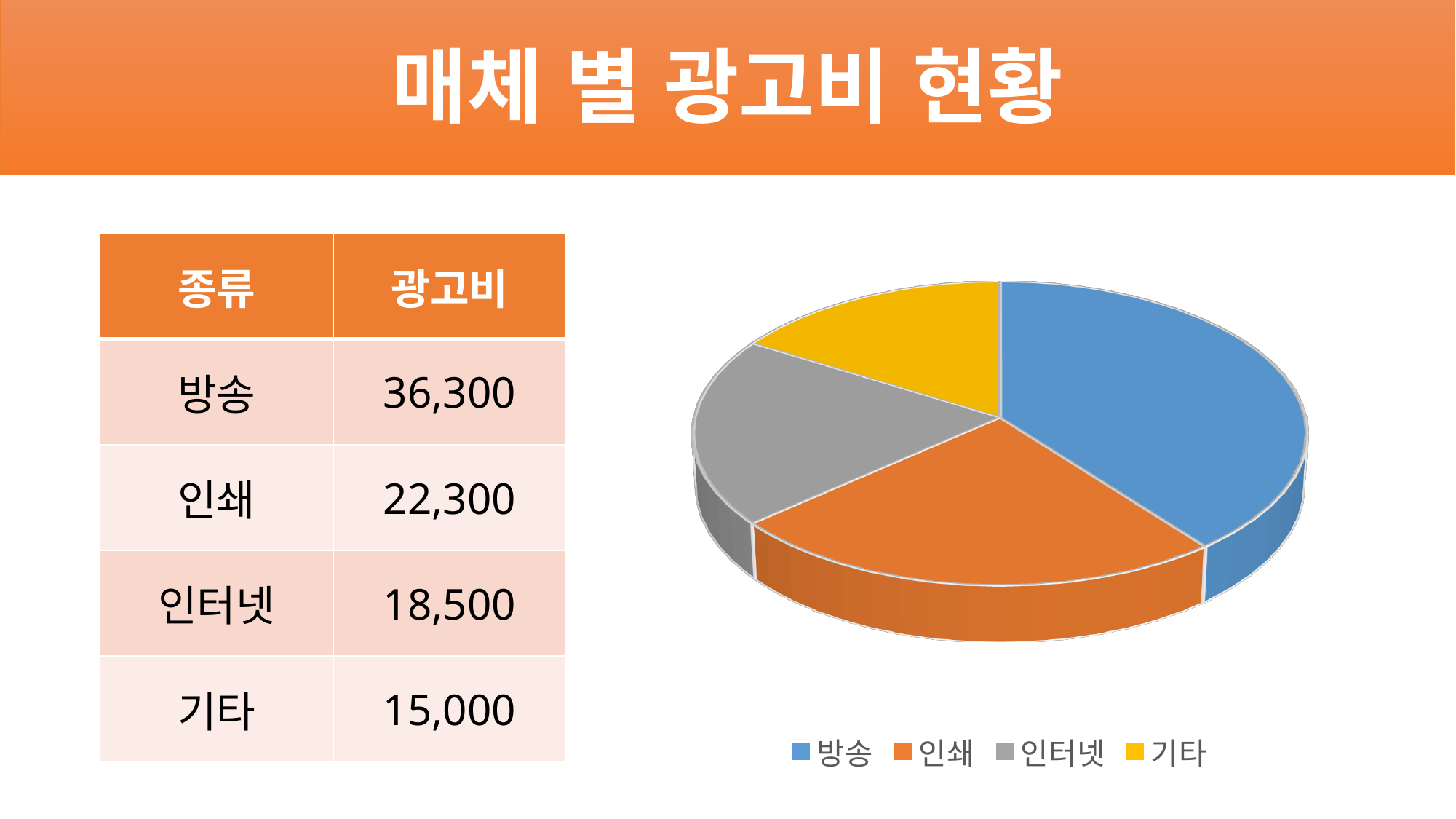
What is the 광고비 value for 인쇄? 22,300 Which category has the lowest 광고비? 기타 What colour is the 방송 slice in the pie chart? Blue Which has a larger 광고비, 인쇄 or 인터넷? 인쇄 What is the difference in 광고비 between 방송 and 인쇄? 14,000 How many categories does the pie chart have? 4 What is the 광고비 value for 인터넷? 18,500 What kind of chart is shown on the slide? Pie chart What is the 광고비 value for 기타? 15,000 What is the 광고비 value for 방송? 36,300 What is the difference in 광고비 between 인터넷 and 기타? 3,500 Which category has the highest 광고비? 방송